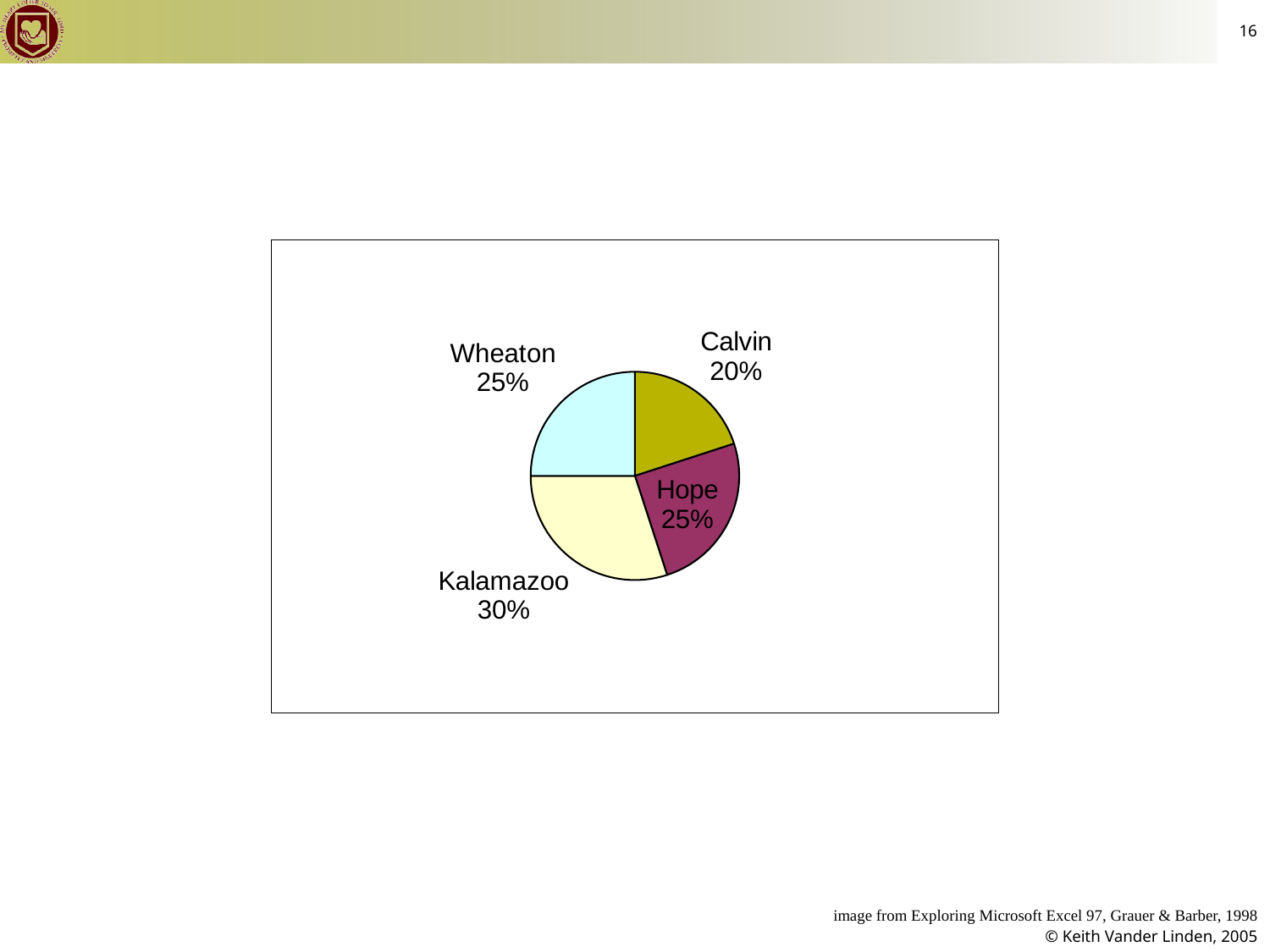
Which slice of the pie is the largest? Kalamazoo What colour is the Hope slice of the pie? dark magenta How many slices does the pie chart have? 4 What is the value shown for Wheaton? 25% What is the value shown for Hope? 25% Which slice of the pie is the smallest? Calvin What is the value shown for Calvin? 20% What percentage of the pie does Kalamazoo account for? 30% What kind of chart is shown on the slide? pie chart What is the difference in percentage points between Wheaton and Calvin? 5 What is the difference in percentage points between Kalamazoo and Calvin? 10 Which is larger, the slice for Kalamazoo or the slice for Hope? Kalamazoo